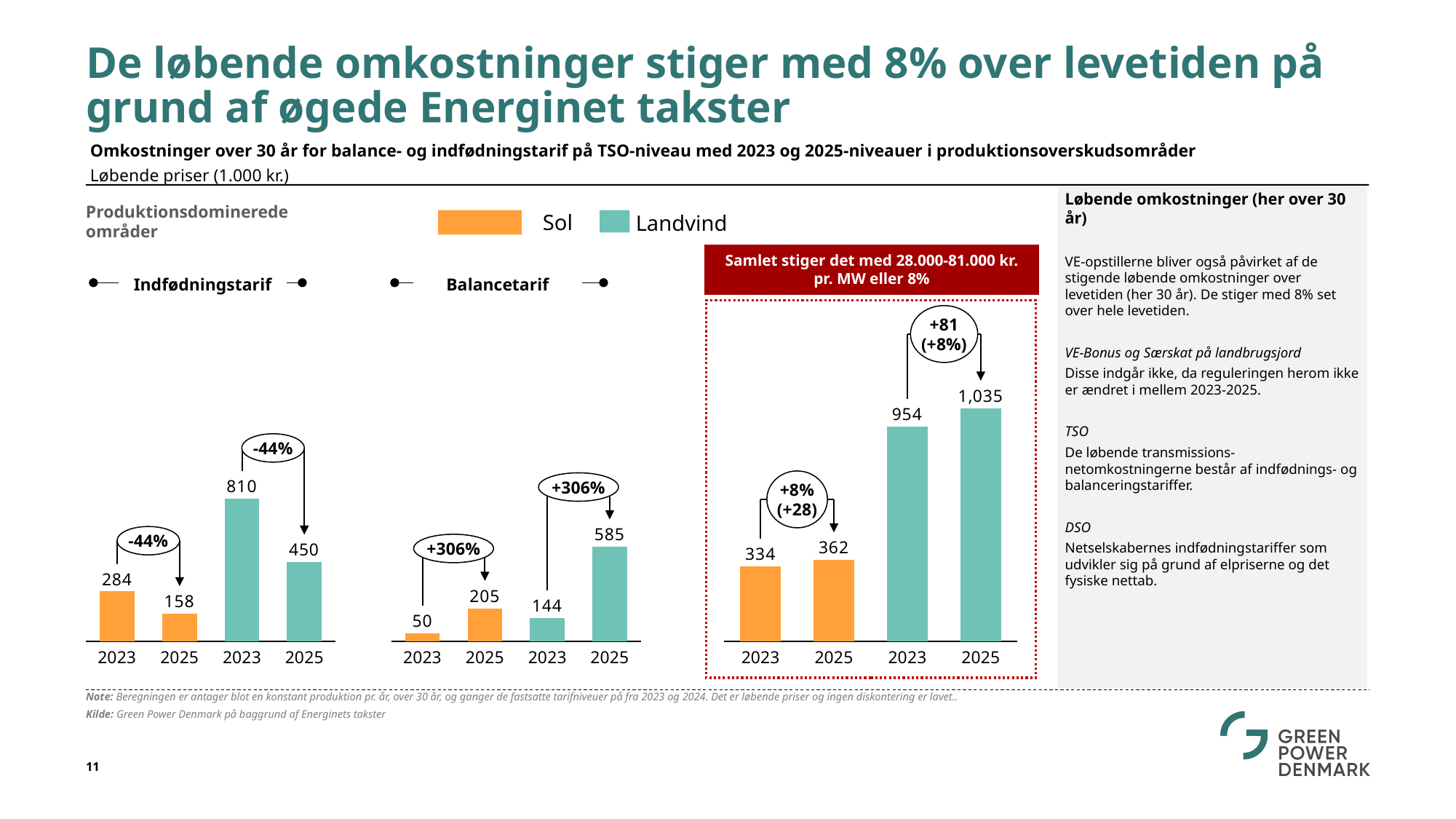
How many series does the legend list? 2 In the Balancetarif chart, what is the value for Landvind in 2025? 585 In the Indfødningstarif chart, what is the difference between the Landvind 2023 and Landvind 2025 values? 360 In the Balancetarif chart, what is the value for Sol in 2023? 50 In the rightmost chart inside the red dotted box, what is the difference between the Sol 2025 and Sol 2023 values? 28 What kind of chart is used on this slide? Bar chart In the Indfødningstarif chart, what is the value for Sol in 2023? 284 In the Balancetarif chart, which bar is the lowest? Sol 2023 In the Indfødningstarif chart, what is the value for Landvind in 2025? 450 In the Balancetarif chart, which is larger: Sol 2025 or Landvind 2023? Sol 2025 In the rightmost chart inside the red dotted box, what is the value for Landvind in 2025? 1,035 In the Indfødningstarif chart, which bar is the highest? Landvind 2023